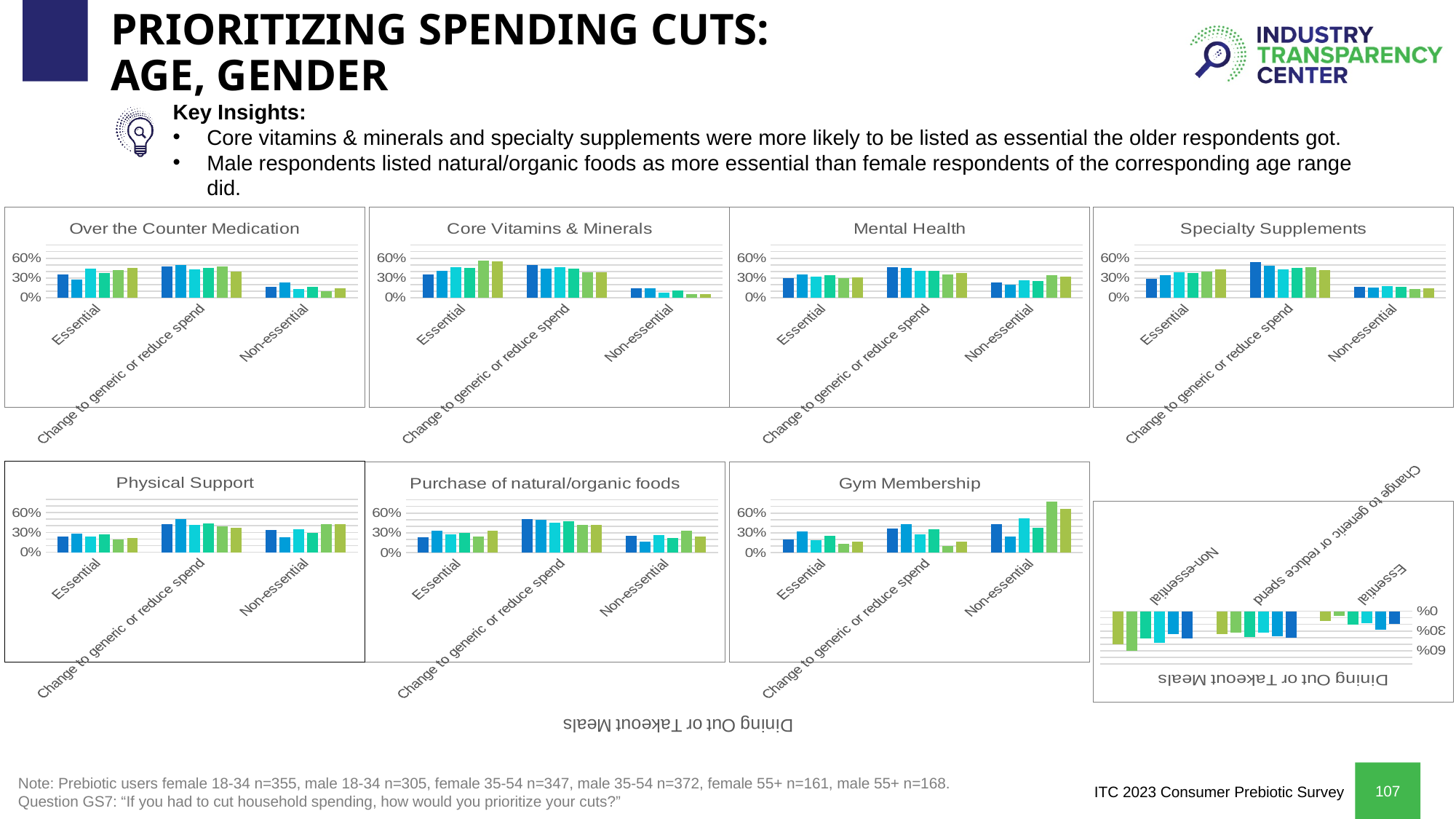
In the "Core Vitamins & Minerals" chart, are all the bars for Non-essential greater or less than 30%? less In the "Core Vitamins & Minerals" chart, which category has the lowest bars? Non-essential In the "Mental Health" chart, is the tallest bar for Essential greater or less than 60%? less In the "Purchase of natural/organic foods" chart, which category has the tallest bars? Change to generic or reduce spend In the "Specialty Supplements" chart, are all the bars for Non-essential greater or less than 30%? less What kind of chart is the "Over the Counter Medication" chart? bar chart What is the title of the chart in the bottom-right corner of the slide? Dining Out or Takeout Meals How many categories are shown on the x axis of the "Over the Counter Medication" chart? 3 In the "Gym Membership" chart, which category contains the tallest bar? Non-essential